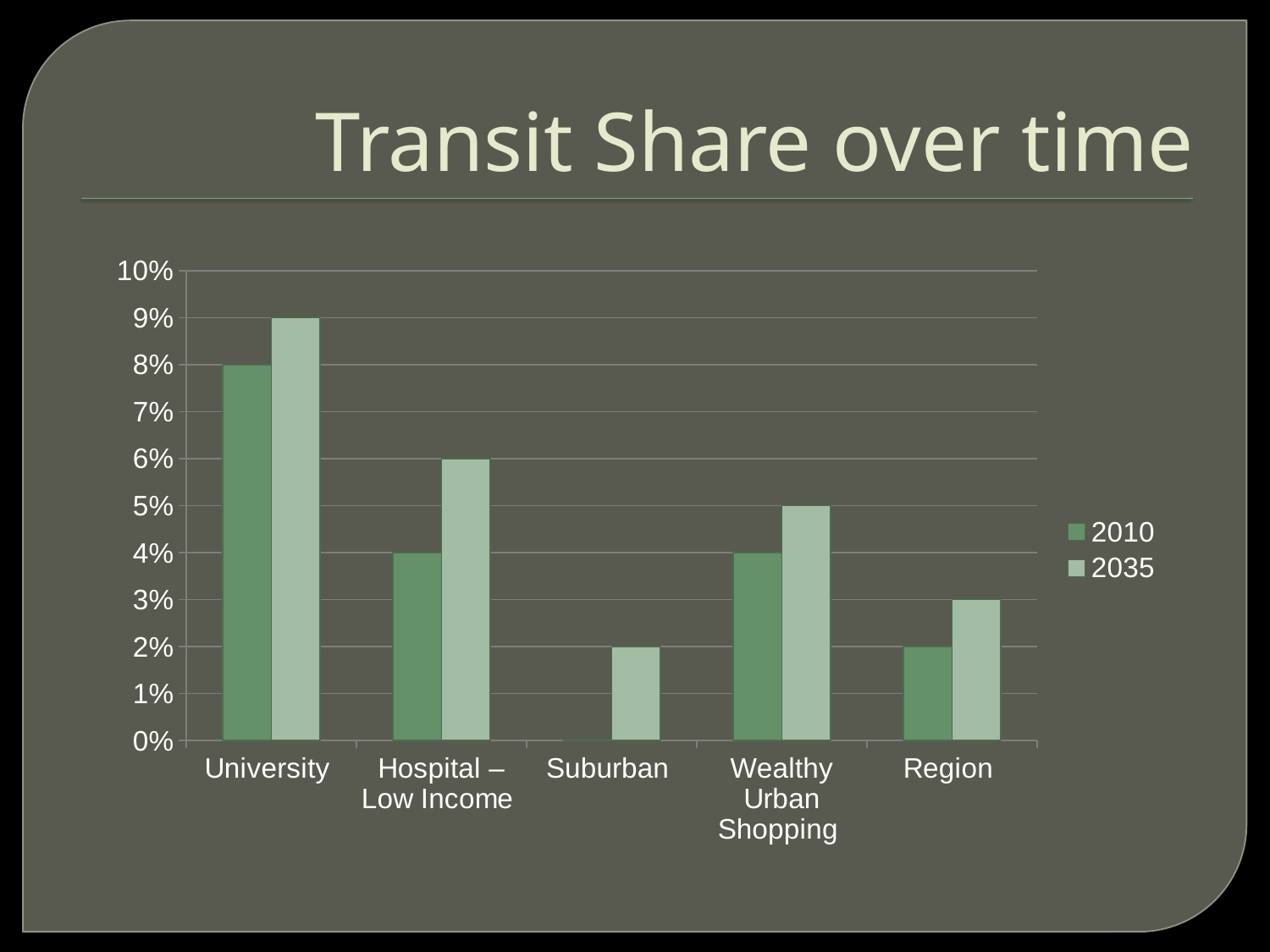
What is the 2035 transit share for Suburban? 2% How many series does the legend list? 2 How many categories are shown on the x axis? 5 What is the difference between the 2035 and 2010 transit share for Hospital – Low Income? 2% What is the 2010 transit share for University? 8% Which category has the lowest 2010 transit share? Suburban What kind of chart is shown on the slide? Bar chart Which is larger, the 2035 transit share for Wealthy Urban Shopping or the 2035 transit share for Region? Wealthy Urban Shopping What is the 2010 transit share for Region? 2% Is the 2035 transit share for University greater or less than 5%? greater Which category has the highest 2035 transit share? University What is the 2035 transit share for Hospital – Low Income? 6%